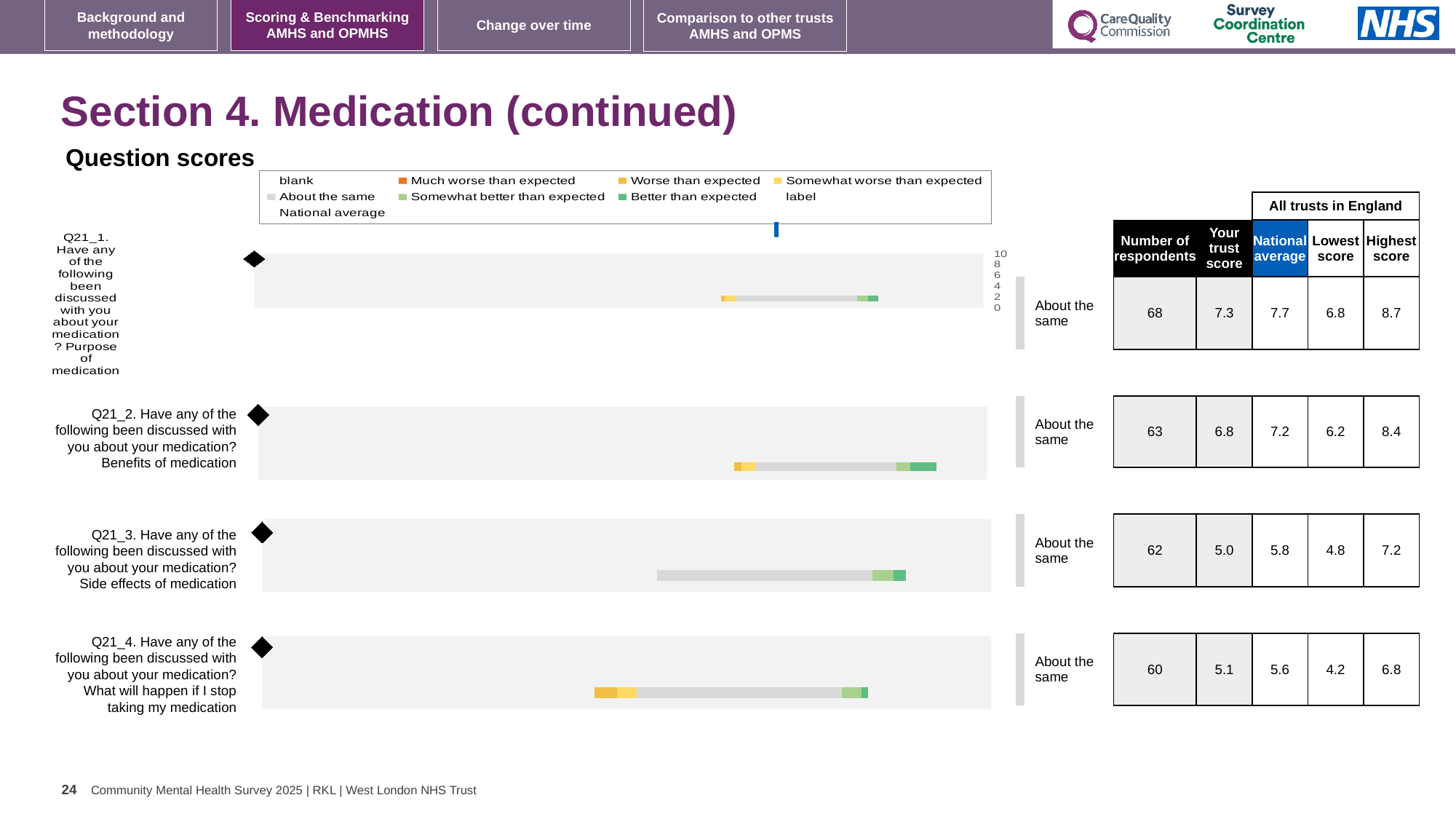
How many entries does the legend above the charts list? 9 What is the highest score across all trusts in England for Q21_4 (What will happen if I stop taking my medication)? 6.8 Which question has the lowest 'Your trust score'? Q21_3 (Side effects of medication) What is the national average for Q21_3 (Side effects of medication)? 5.8 How many questions (Q21_1 to Q21_4) are charted on this slide? 4 Which legend entry is shown in dark orange? Much worse than expected What benchmark category is shown for Q21_4? About the same What is the 'Your trust score' for Q21_1 (Purpose of medication)? 7.3 What kind of chart is used to show the question scores on this slide? bar chart Which question has the highest 'Your trust score'? Q21_1 (Purpose of medication) For Q21_2 (Benefits of medication), which is larger: the trust score or the national average? National average What is the difference between the national average and the trust score for Q21_1? 0.4